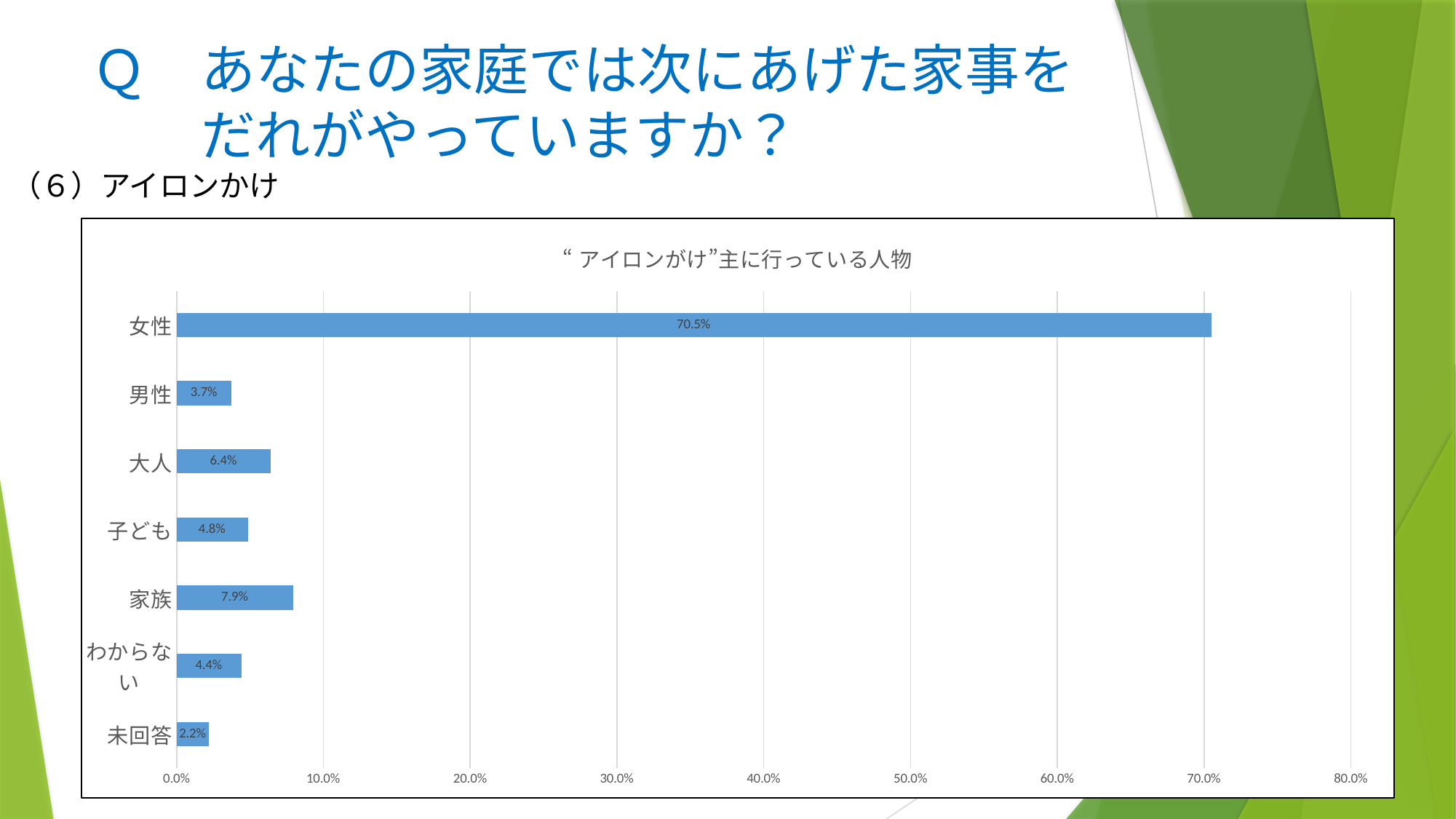
What is the value for 未回答? 2.2% How many categories are shown in the chart? 7 Which category has the highest value? 女性 What is the difference between the values for 大人 and 子ども? 1.6% What kind of chart is shown on the slide? Bar chart What is the value for 家族? 7.9% Is the value for 女性 greater or less than 70.0%? greater Which category has the lowest value? 未回答 What is the value for 女性? 70.5% Which is larger, the value for 家族 or the value for 大人? 家族 What is the difference between the values for 女性 and 男性? 66.8% What is the title of the chart? “アイロンがけ”主に行っている人物